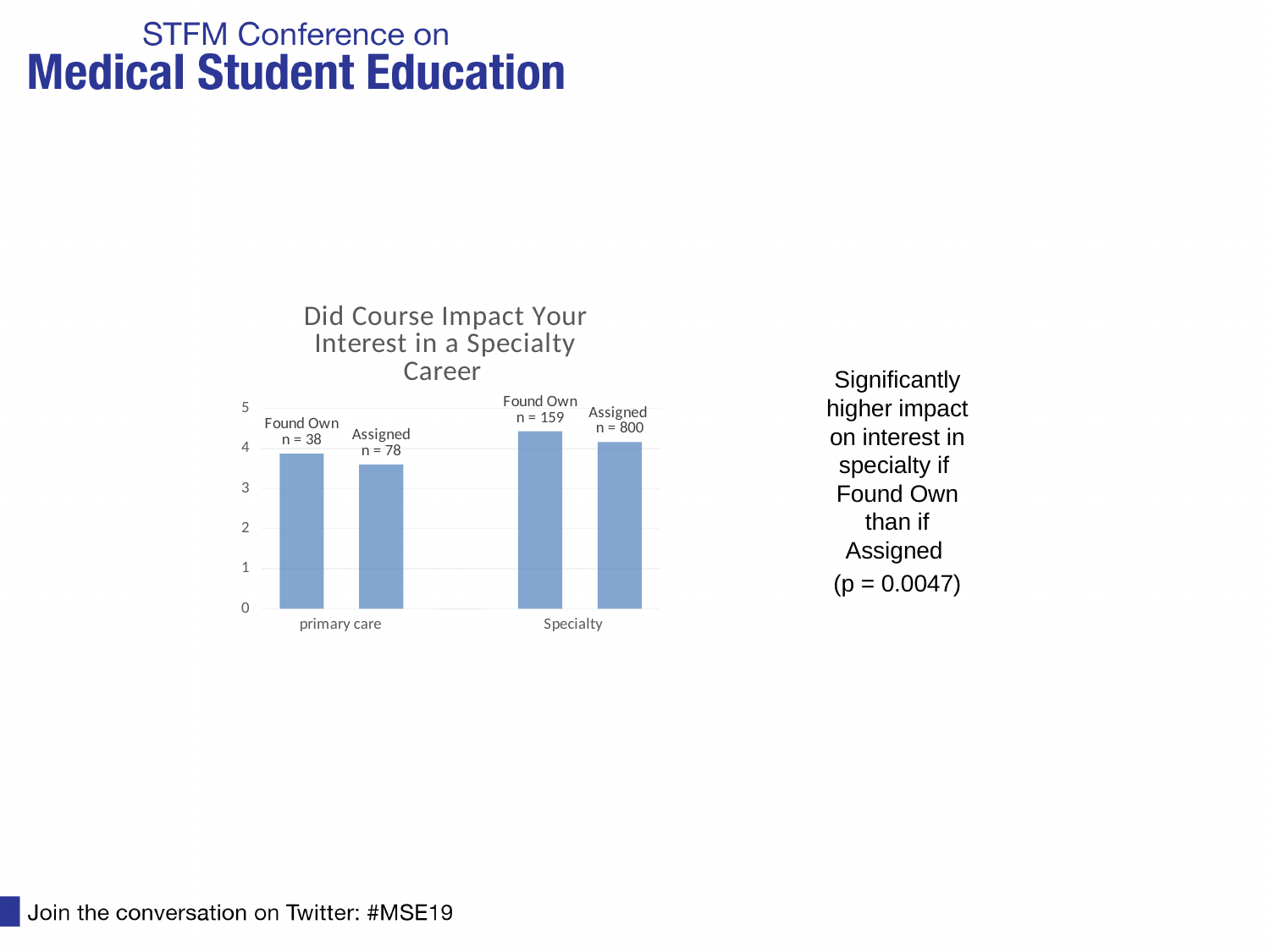
What is the title of the chart? Did Course Impact Your Interest in a Specialty Career What is the sample size (n) for the Found Own bar in the Specialty group? n = 159 What is the sample size (n) for the Found Own bar in the primary care group? n = 38 In the primary care group, which bar is taller, Found Own or Assigned? Found Own What kind of chart is shown on the slide? bar chart What is the sample size (n) for the Assigned bar in the Specialty group? n = 800 How many bars are plotted in the chart? 4 Which bar is the highest in the chart? Found Own in Specialty What are the two category groups shown on the x axis? primary care and Specialty Which bar is the lowest in the chart? Assigned in primary care Is the value for Assigned in the primary care group greater or less than 4? less Is the value for Found Own in the Specialty group greater or less than 4? greater